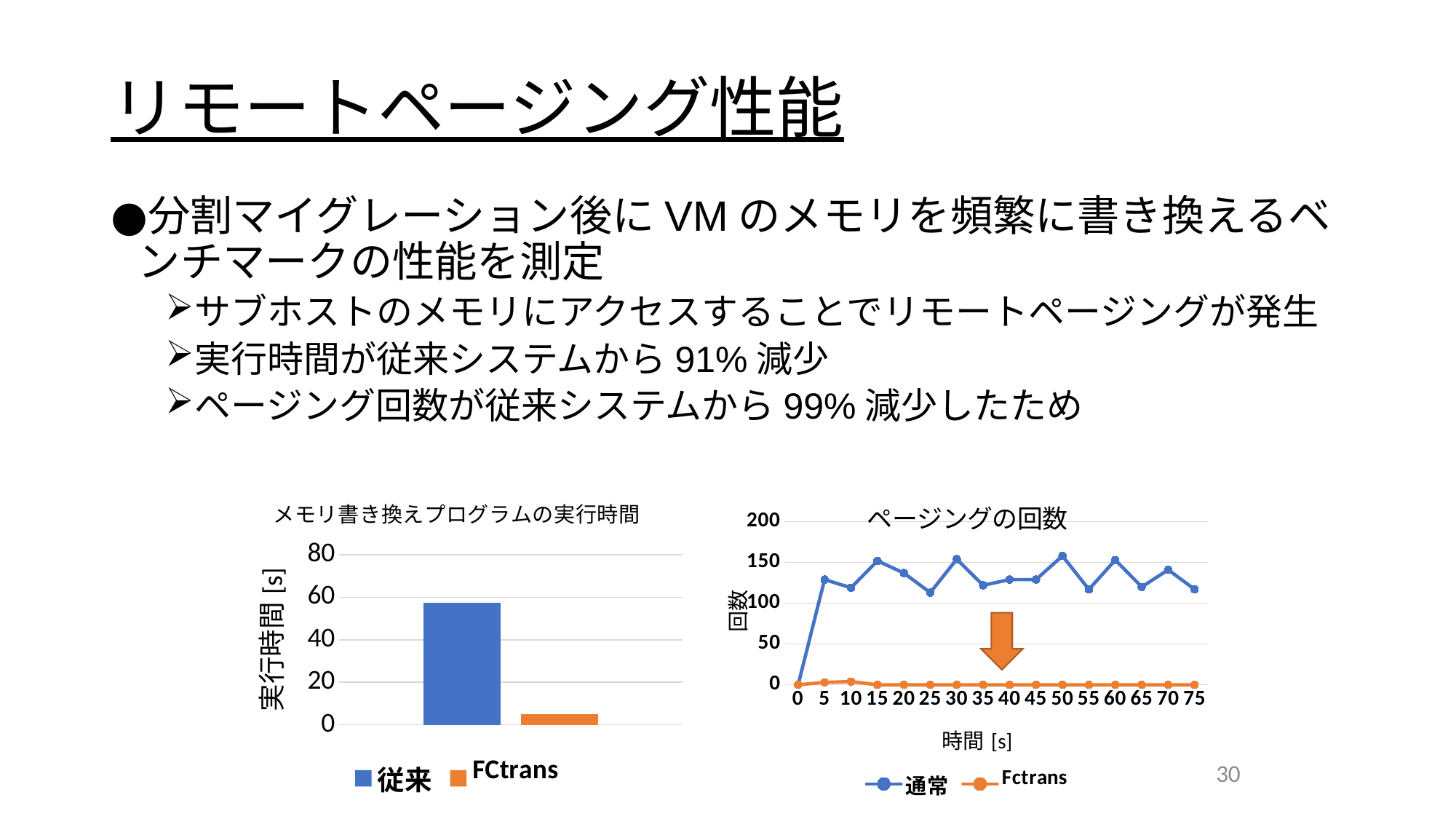
In the left chart (メモリ書き換えプログラムの実行時間), which series has the larger execution time, 従来 or FCtrans? 従来 In the left chart (メモリ書き換えプログラムの実行時間), is the value for FCtrans greater or less than 20? less What kind of chart is the right chart titled ページングの回数? line chart In the left chart (メモリ書き換えプログラムの実行時間), how many series does the legend list? 2 What is the y-axis label of the left chart (メモリ書き換えプログラムの実行時間)? 実行時間 [s] In the left chart (メモリ書き換えプログラムの実行時間), is the value for 従来 greater or less than 40? greater In the right chart (ページングの回数), is the value for Fctrans at time 40 greater or less than 50? less In the right chart (ページングの回数), which series has higher values over the measured period, 通常 or Fctrans? 通常 What kind of chart is the left chart titled メモリ書き換えプログラムの実行時間? bar chart In the right chart (ページングの回数), how many series does the legend list? 2 In the right chart (ページングの回数), how many time points are labelled on the x axis? 16